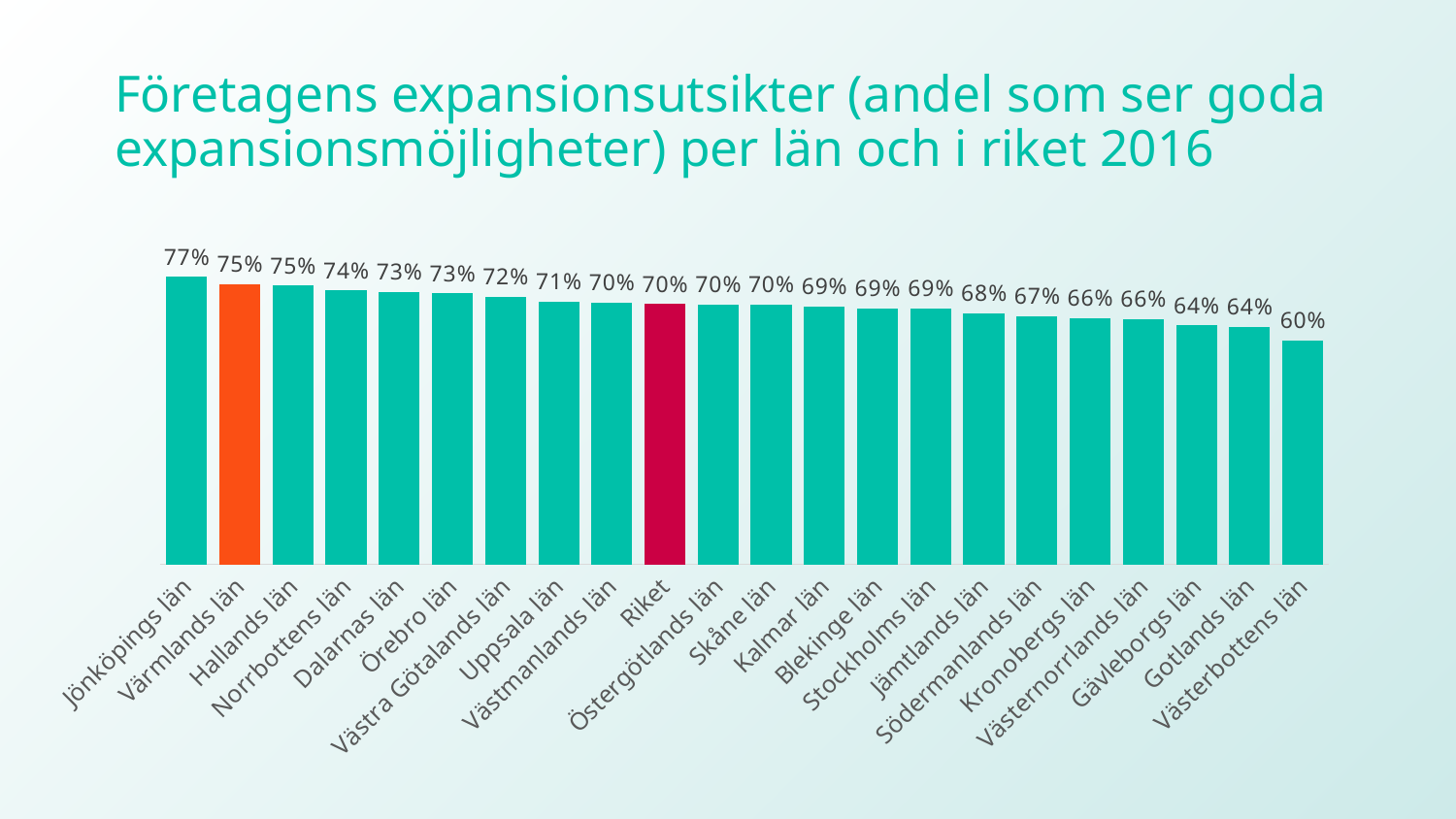
How many categories are shown in the chart? 22 Which is larger, the value for Norrbottens län or the value for Gotlands län? Norrbottens län What is the value for Jönköpings län? 77% What kind of chart is shown on the slide? Bar chart Which bar is coloured orange? Värmlands län What is the difference between the values for Värmlands län and Riket? 5% Which category has the highest value? Jönköpings län Which category has the lowest value? Västerbottens län What is the value for Stockholms län? 69% What is the value for Riket? 70% What is the difference between the values for Jönköpings län and Västerbottens län? 17% What is the value for Västerbottens län? 60%